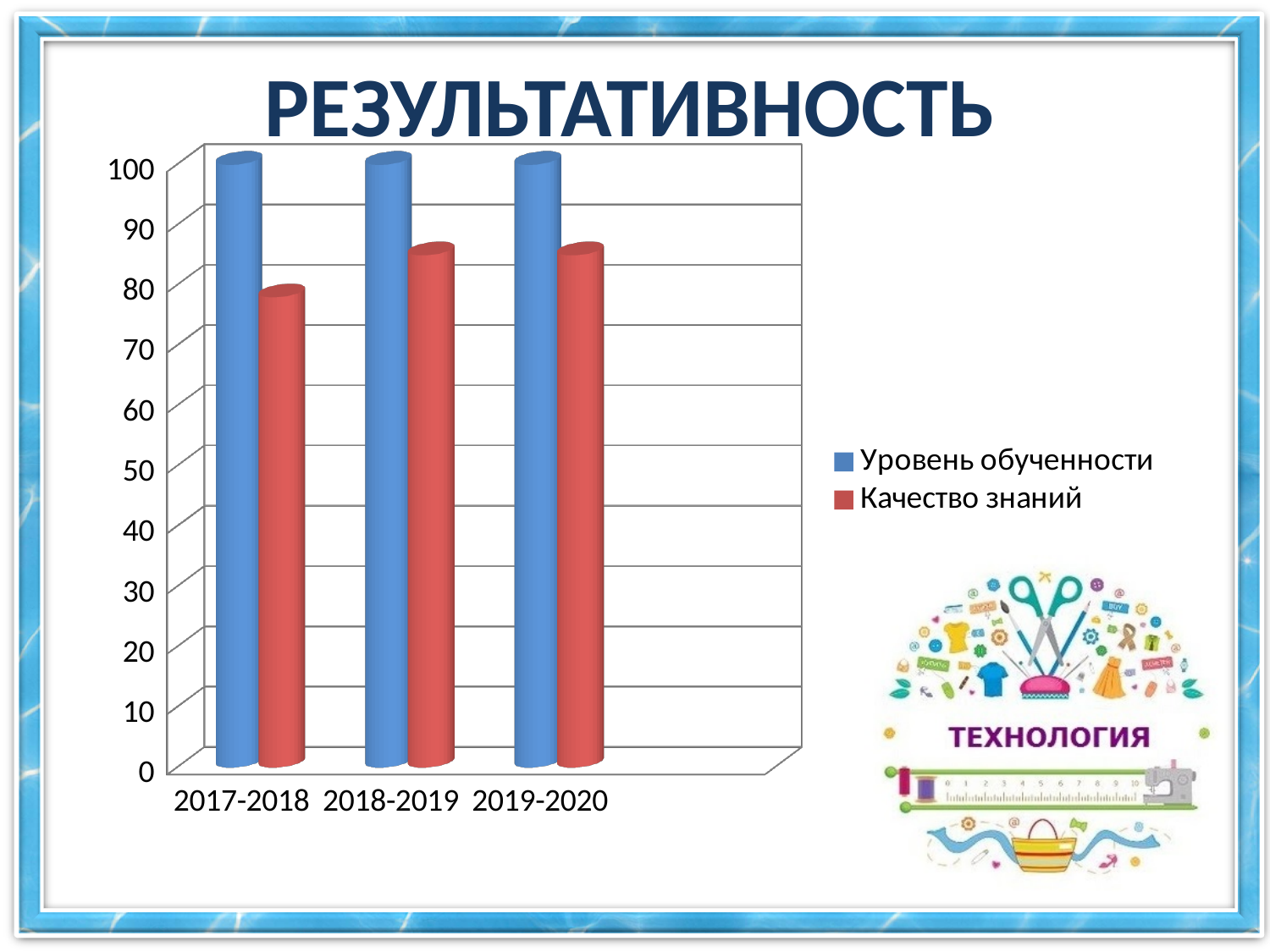
Which series has the higher value in 2019-2020? Уровень обученности What kind of chart is shown on the slide? bar chart Is the value of Уровень обученности for 2018-2019 greater or less than 90? greater Is the value of Качество знаний for 2018-2019 greater or less than 80? greater Which series is shown in red? Качество знаний What is the title of the slide containing the chart? РЕЗУЛЬТАТИВНОСТЬ Is the value of Качество знаний for 2019-2020 greater or less than 90? less Which is larger for Качество знаний: 2017-2018 or 2018-2019? 2018-2019 Which category has the lowest value for Качество знаний? 2017-2018 How many categories are shown on the x axis? 3 How many series does the legend list? 2